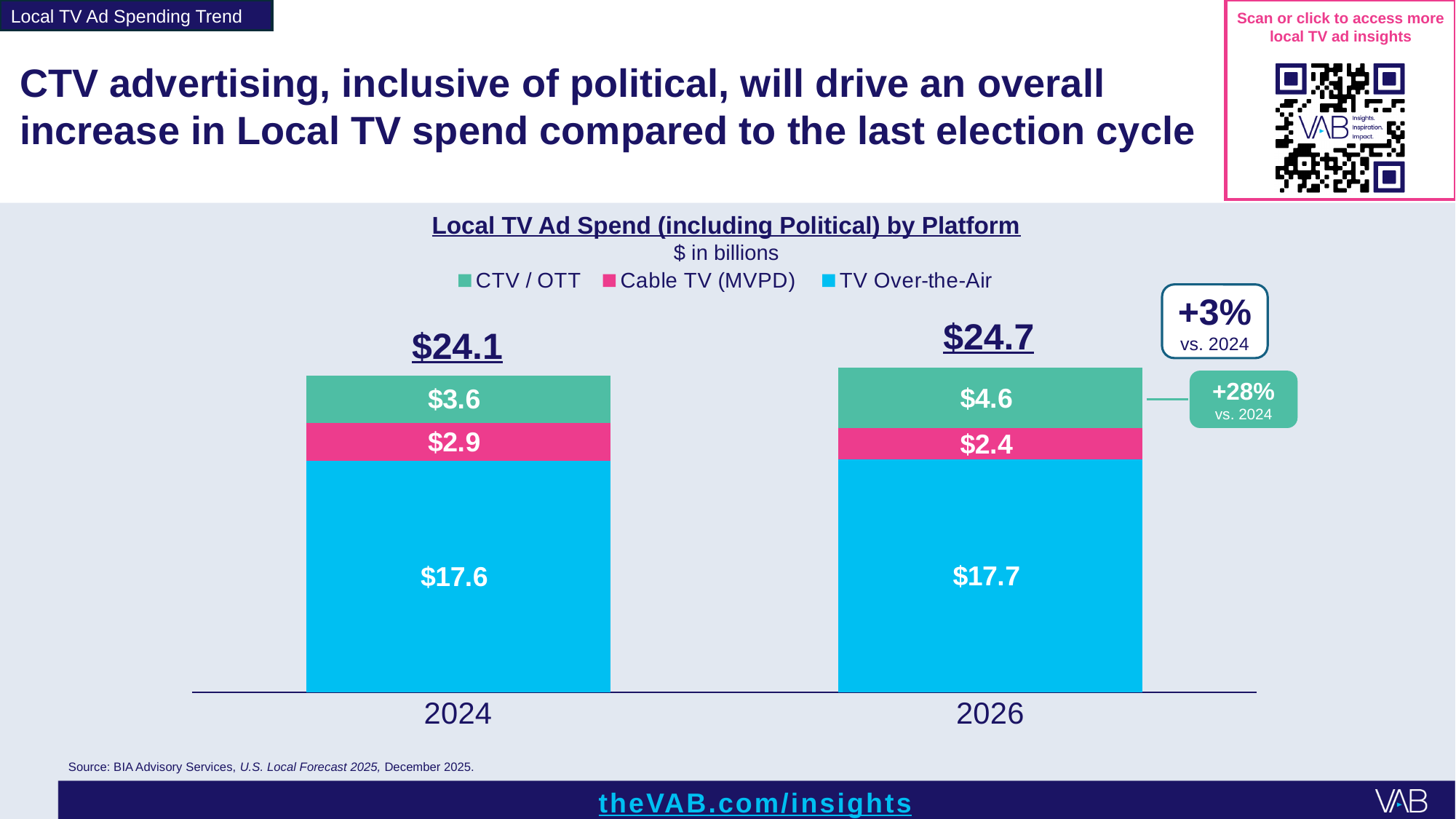
What is the difference between the CTV / OTT values for 2026 and 2024? $1.0 What is the total of the stacked bar for 2026? $24.7 Which is larger, the Cable TV (MVPD) value for 2024 or for 2026? 2024 What is the TV Over-the-Air value for 2024? $17.6 What is the total of the stacked bar for 2024? $24.1 How many series does the legend list? 3 Which platform has the lowest value in 2026? Cable TV (MVPD) What is the Cable TV (MVPD) value for 2026? $2.4 What kind of chart is shown? Stacked bar chart Which platform has the highest value in 2026? TV Over-the-Air What is the CTV / OTT value for 2024? $3.6 What is the title of the chart? Local TV Ad Spend (including Political) by Platform